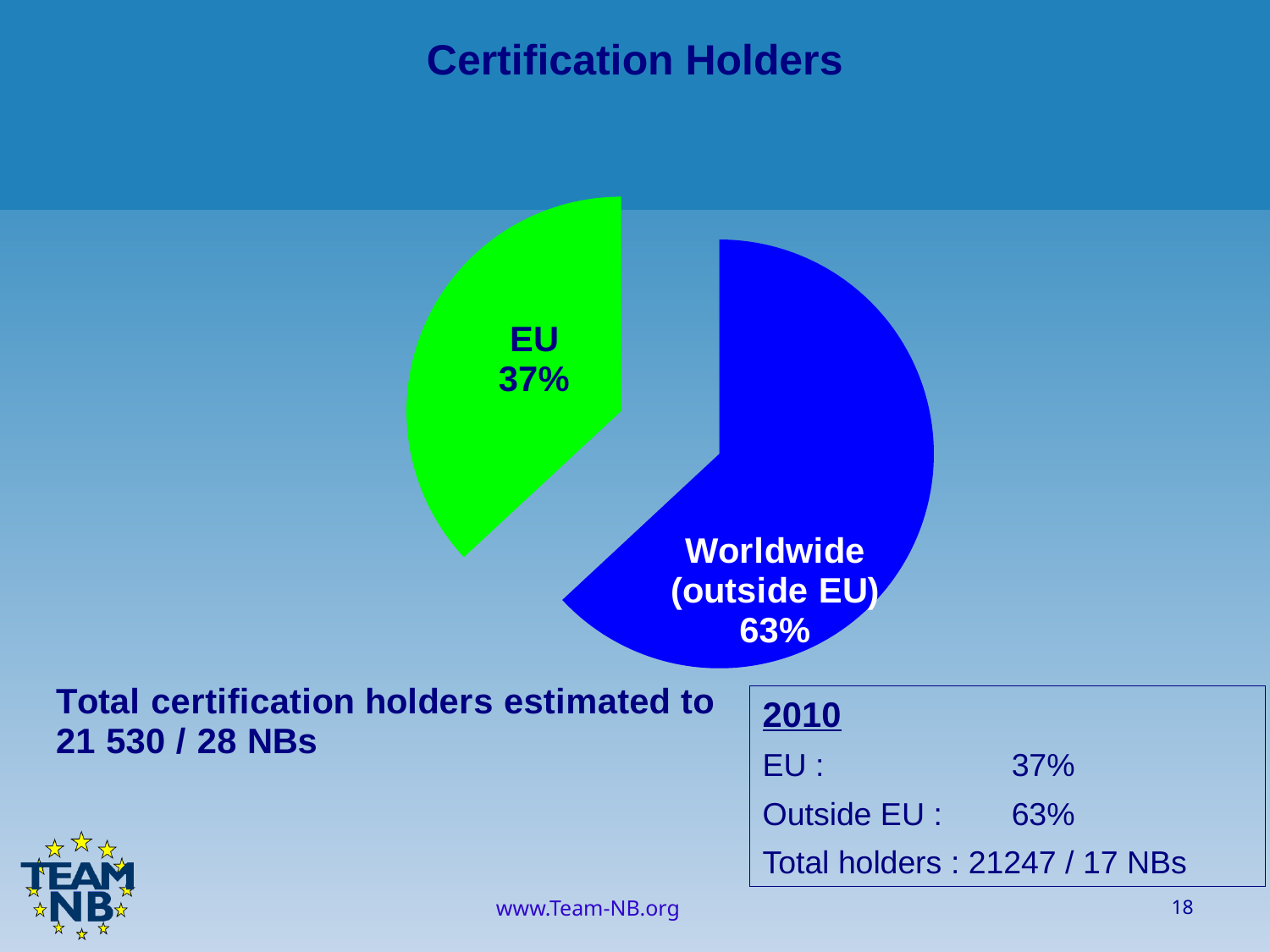
How many slices does the pie chart have? 2 Which slice of the pie is the largest? Worldwide (outside EU) Which slice of the pie is the smallest? EU What is the combined share of the EU and Worldwide (outside EU) slices? 100% What is the difference in percentage points between the Worldwide (outside EU) slice and the EU slice? 26 Is the share for EU greater or less than 50%? less What colour is the EU slice of the pie chart? green Which is larger, the EU slice or the Worldwide (outside EU) slice? Worldwide (outside EU) What is the title of the slide containing the pie chart? Certification Holders What kind of chart is shown on the slide? pie chart What share of the pie does the EU slice represent? 37% What share of the pie does the Worldwide (outside EU) slice represent? 63%